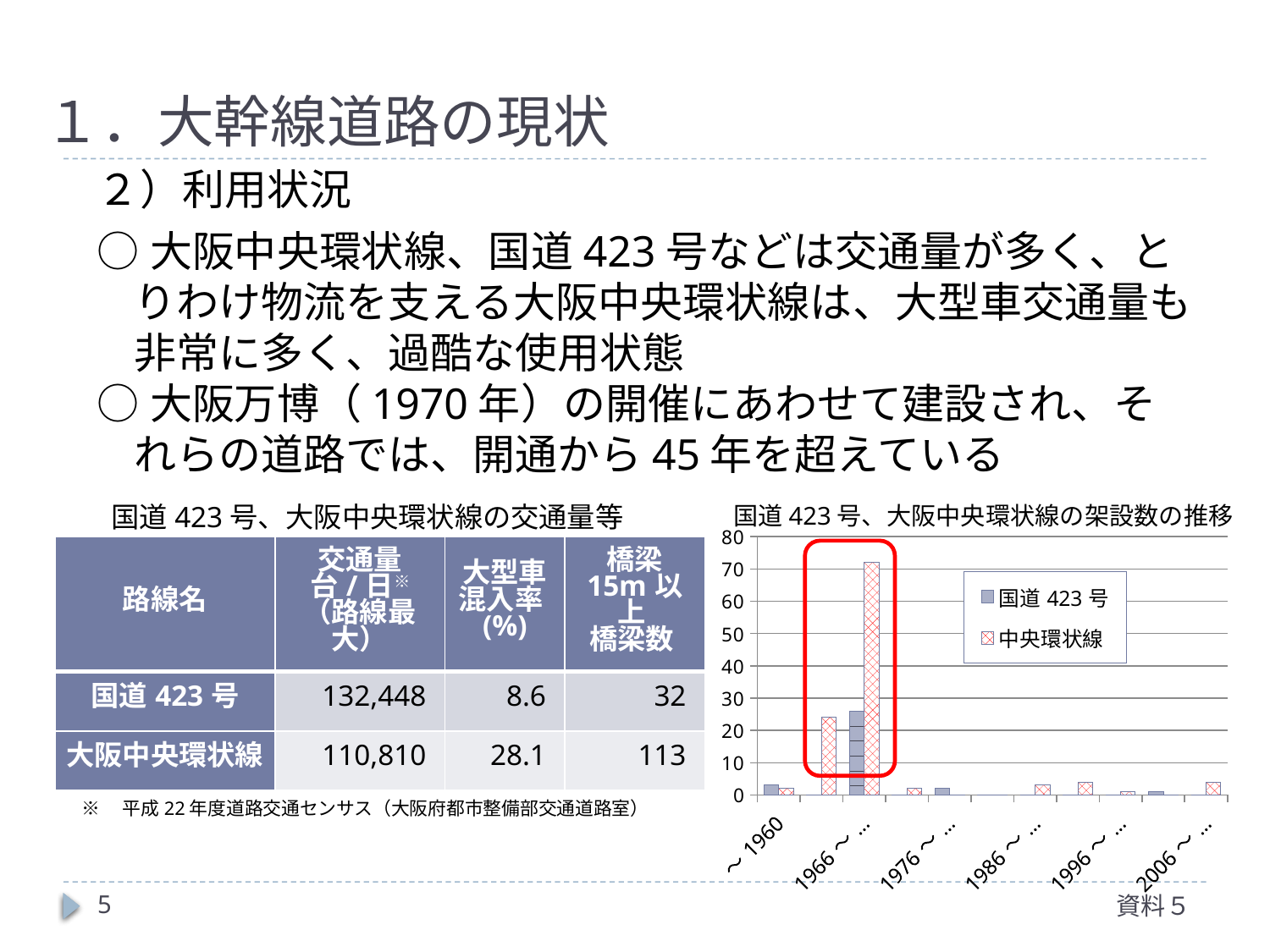
After the peak, do the bars in the later periods (1986～ onward) rise above or fall below the peak level? fall below Is the value for 中央環状線 in the 1966～ category greater or less than 10? greater What is the highest value shown on the chart's vertical axis? 80 Is the tallest bar in the chart greater or less than 60? greater Is the value for 国道423号 in the ～1960 category greater or less than 10? less How many series does the legend of the chart list? 2 Which series has the tallest bar in the chart? 中央環状線 What are the two series named in the chart legend? 国道423号 and 中央環状線 What kind of chart is shown on the slide? bar chart In the period where 中央環状線 reaches its peak, which series has the larger bar, 国道423号 or 中央環状線? 中央環状線